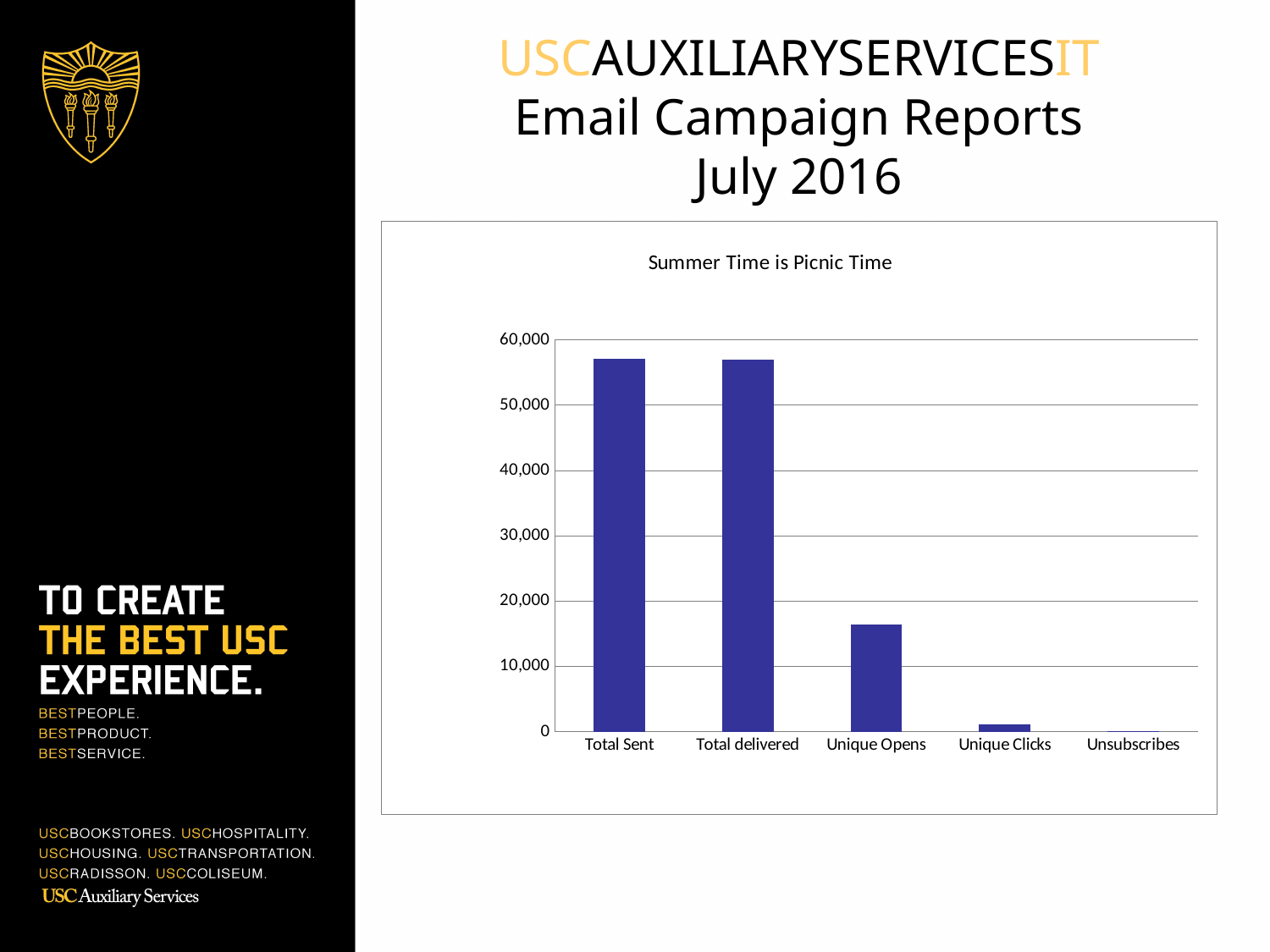
Is the value for Total delivered greater or less than 50,000? greater Is the value for Unique Clicks greater or less than 10,000? less Is the value for Unique Opens greater or less than 20,000? less How many categories are shown on the x axis of the chart? 5 Which category has the lowest value in the chart? Unsubscribes Which is larger, the value for Unique Opens or the value for Unique Clicks? Unique Opens What is the highest value shown on the y axis of the chart? 60,000 Do the values rise or fall moving from left to right along the x axis? fall What type of chart is shown on the slide? Bar chart What is the title of the chart? Summer Time is Picnic Time